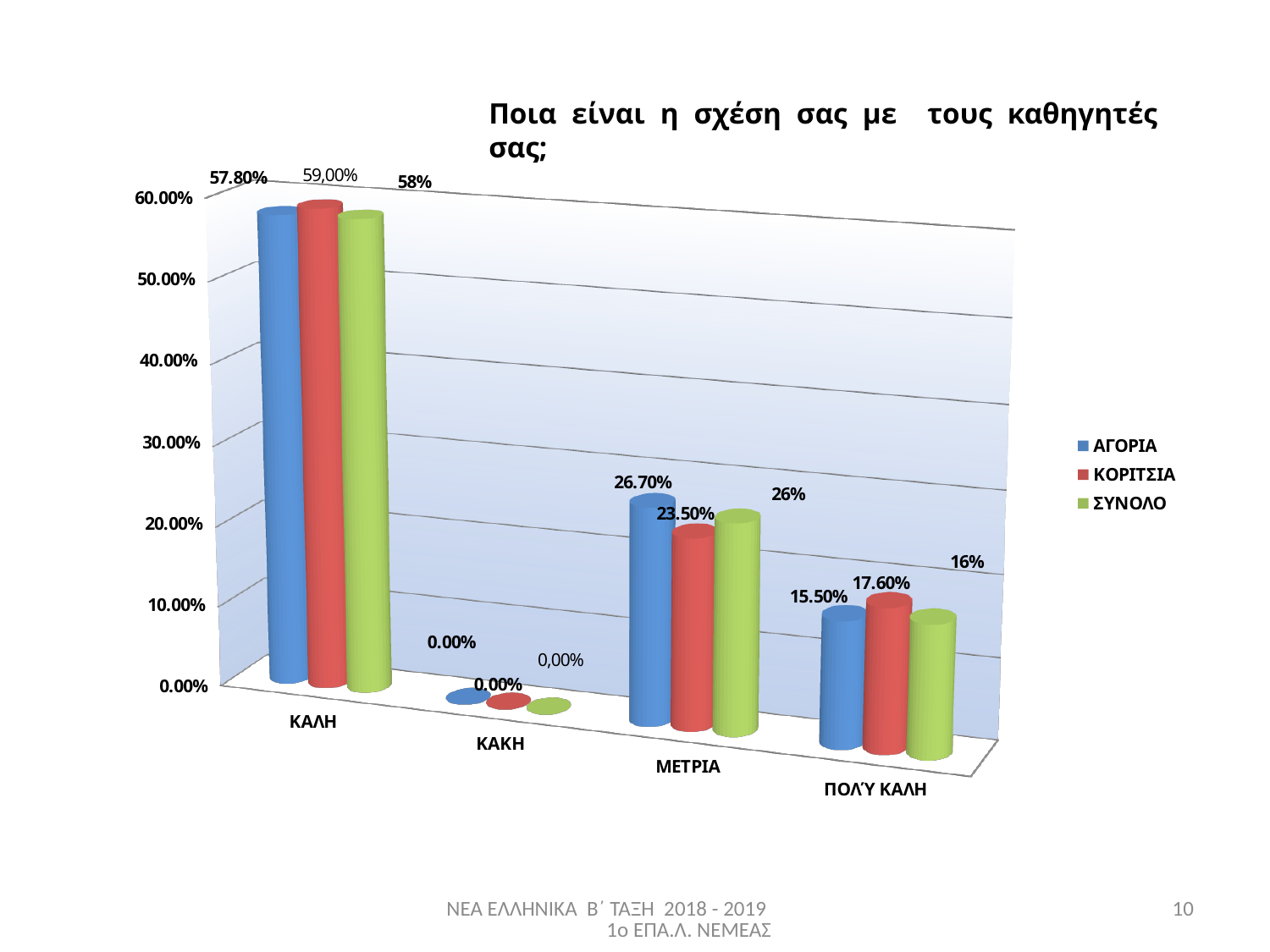
How many categories are shown on the x axis? 4 What is the difference between the ΑΓΟΡΙΑ and ΚΟΡΙΤΣΙΑ values in the ΜΕΤΡΙΑ category? 3.20% What is the value for ΚΟΡΙΤΣΙΑ in the ΜΕΤΡΙΑ category? 23.50% How many series does the legend list? 3 Which category has the lowest value for ΣΥΝΟΛΟ? ΚΑΚΗ What is the value for ΣΥΝΟΛΟ in the ΠΟΛΎ ΚΑΛΗ category? 16% Is the value for ΑΓΟΡΙΑ in the ΜΕΤΡΙΑ category greater or less than 20.00%? greater In the ΠΟΛΎ ΚΑΛΗ category, which is larger: ΑΓΟΡΙΑ or ΚΟΡΙΤΣΙΑ? ΚΟΡΙΤΣΙΑ Which category has the highest value for ΑΓΟΡΙΑ? ΚΑΛΗ What kind of chart is shown on the slide? bar chart What is the value for ΚΟΡΙΤΣΙΑ in the ΠΟΛΎ ΚΑΛΗ category? 17.60% What is the value for ΑΓΟΡΙΑ in the ΚΑΛΗ category? 57.80%